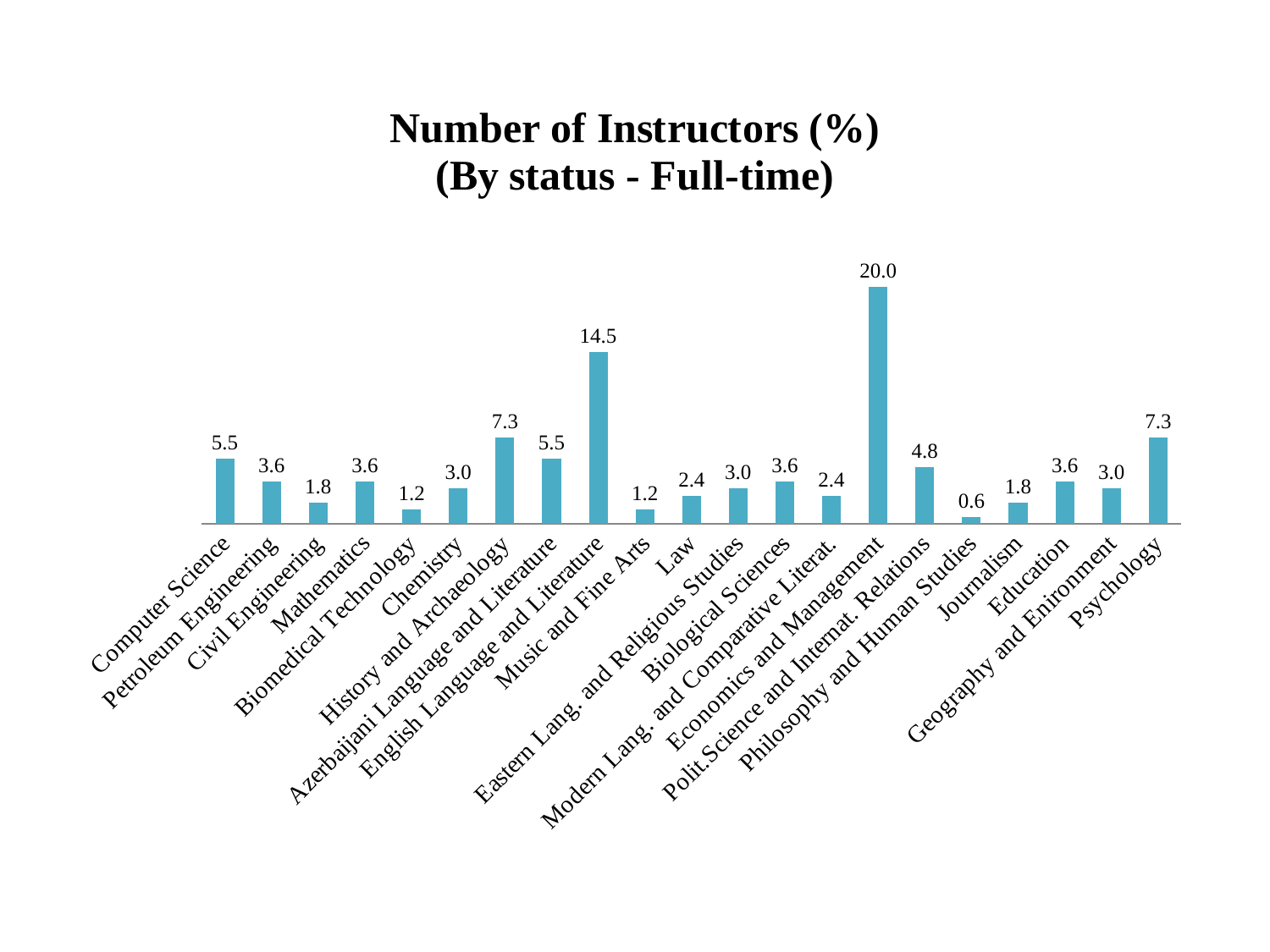
What is the value for English Language and Literature? 14.5 What kind of chart is shown on the slide? Bar chart What is the difference between the values for History and Archaeology and Chemistry? 4.3 Which is larger, the value for Computer Science or the value for Law? Computer Science Which category has the lowest value? Philosophy and Human Studies How many categories are shown on the x axis? 21 What is the value for Economics and Management? 20.0 Which category has the highest value? Economics and Management What is the value for Journalism? 1.8 What is the title of the chart? Number of Instructors (%) (By status - Full-time) What is the value for Polit.Science and Internat. Relations? 4.8 What is the difference between the values for Economics and Management and English Language and Literature? 5.5